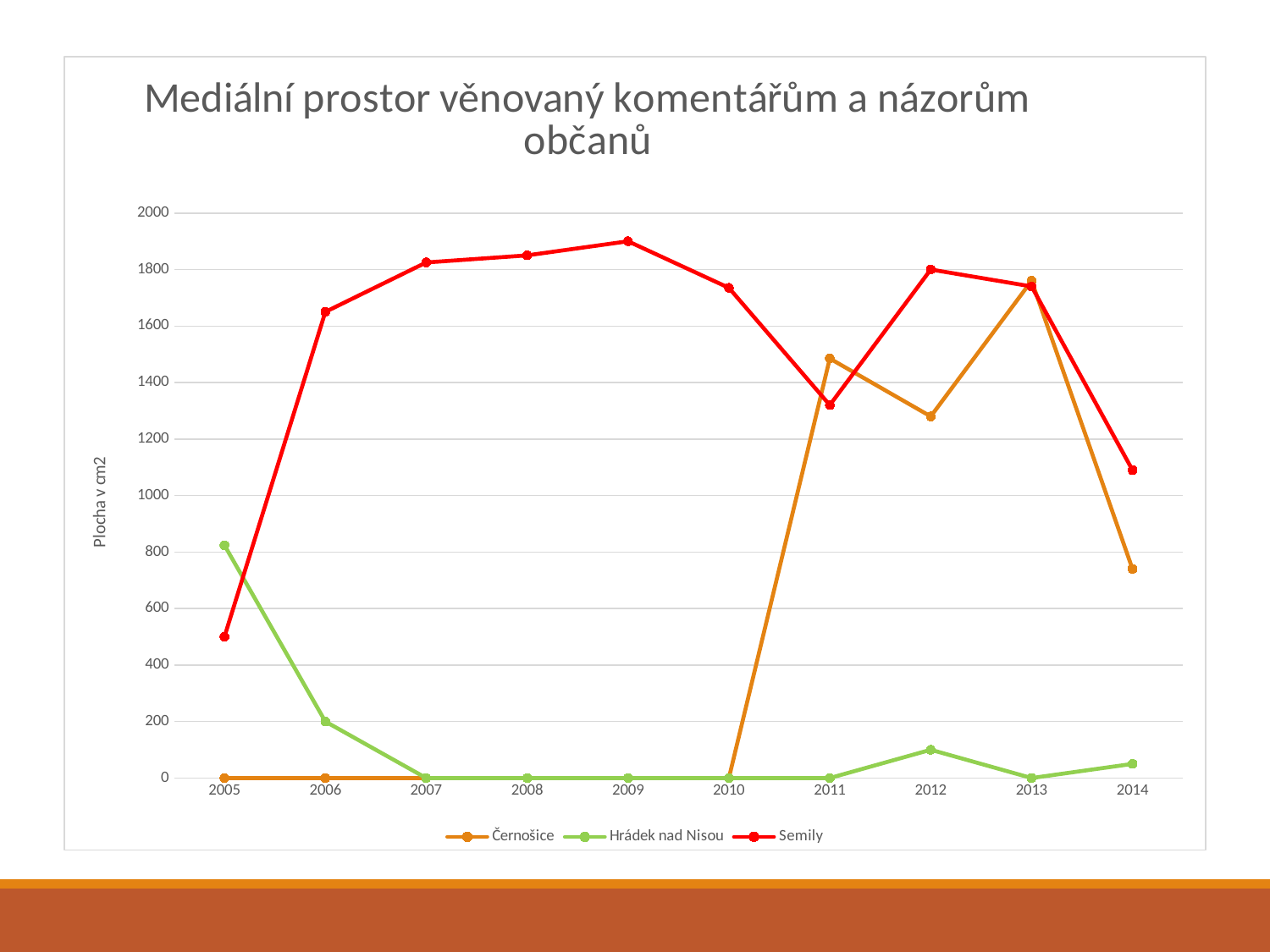
In which year does Semily reach its highest value? 2009 How many series does the legend list? 3 What is the value for Semily in 2012? 1800 What kind of chart is shown on the slide? line chart Which series has the larger value in 2012, Semily or Černošice? Semily What is the value for Černošice in 2008? 0 In which year does Semily have its lowest value? 2005 How many years are shown on the x axis? 10 Is the value for Černošice in 2014 greater or less than 800? less What is the value for Hrádek nad Nisou in 2006? 200 What is the label on the y axis? Plocha v cm2